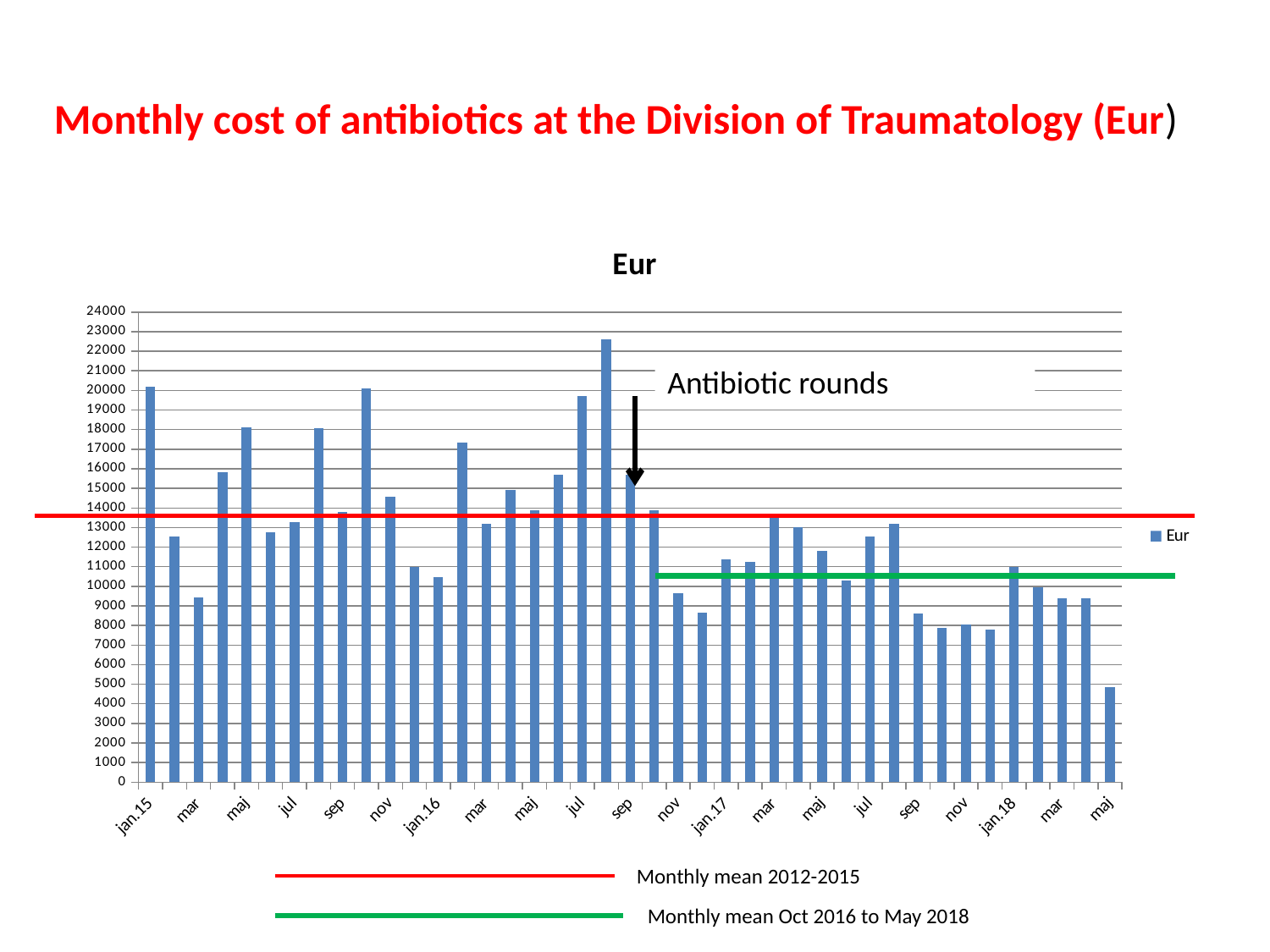
Which month has the lowest bar in the chart? maj (2018) Is the value for nov 2017 (the 'nov' before jan.18) greater or less than 9000? less Is the value for the last bar, maj 2018, greater or less than 6000? less Is the value for jan.16 greater or less than 11000? less Which is larger, the value for jan.15 or the value for jan.16? jan.15 How many series does the chart legend list? 1 How many bars are plotted in the chart? 41 Which is larger, the value for jul 2016 or the value for jul 2017? jul 2016 According to the legend below the chart, what does the red horizontal line represent? Monthly mean 2012-2015 What kind of chart is shown on the slide? bar chart